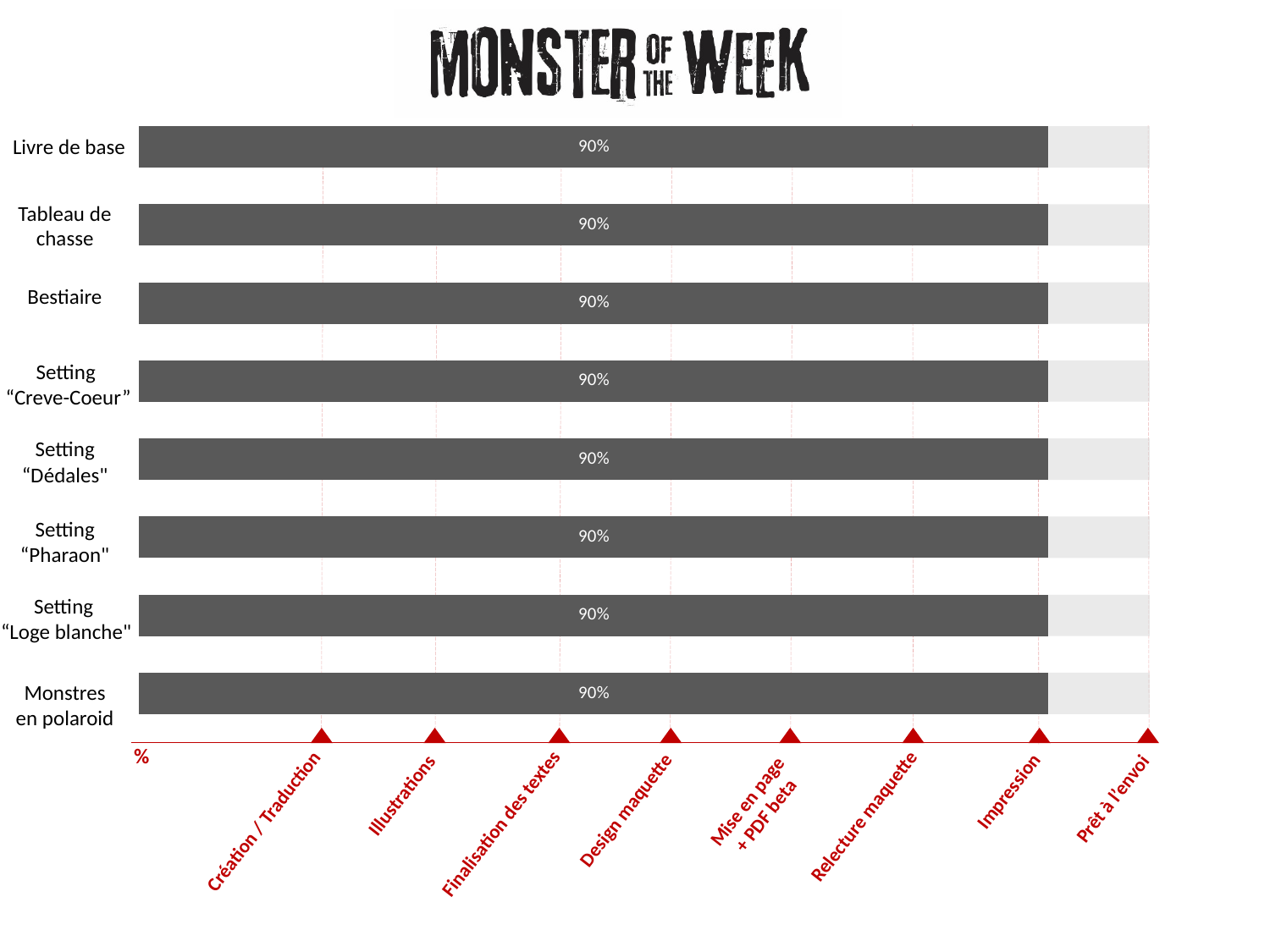
What is the value for Livre de base? 90% What is the difference between the values for Livre de base and Setting "Dédales"? 0% What is the value for Setting "Pharaon"? 90% What is the value for Monstres en polaroid? 90% What kind of chart is shown on the slide? bar chart How many categories (rows) are shown in the chart? 8 What is the value for Tableau de chasse? 90% Is the value for Setting "Loge blanche" greater or less than 50%? greater Which milestone label on the x axis do the bars reach? Impression What is the title shown above the chart? Monster of the Week How many milestone markers are shown along the x axis? 8 What is the value for Bestiaire? 90%